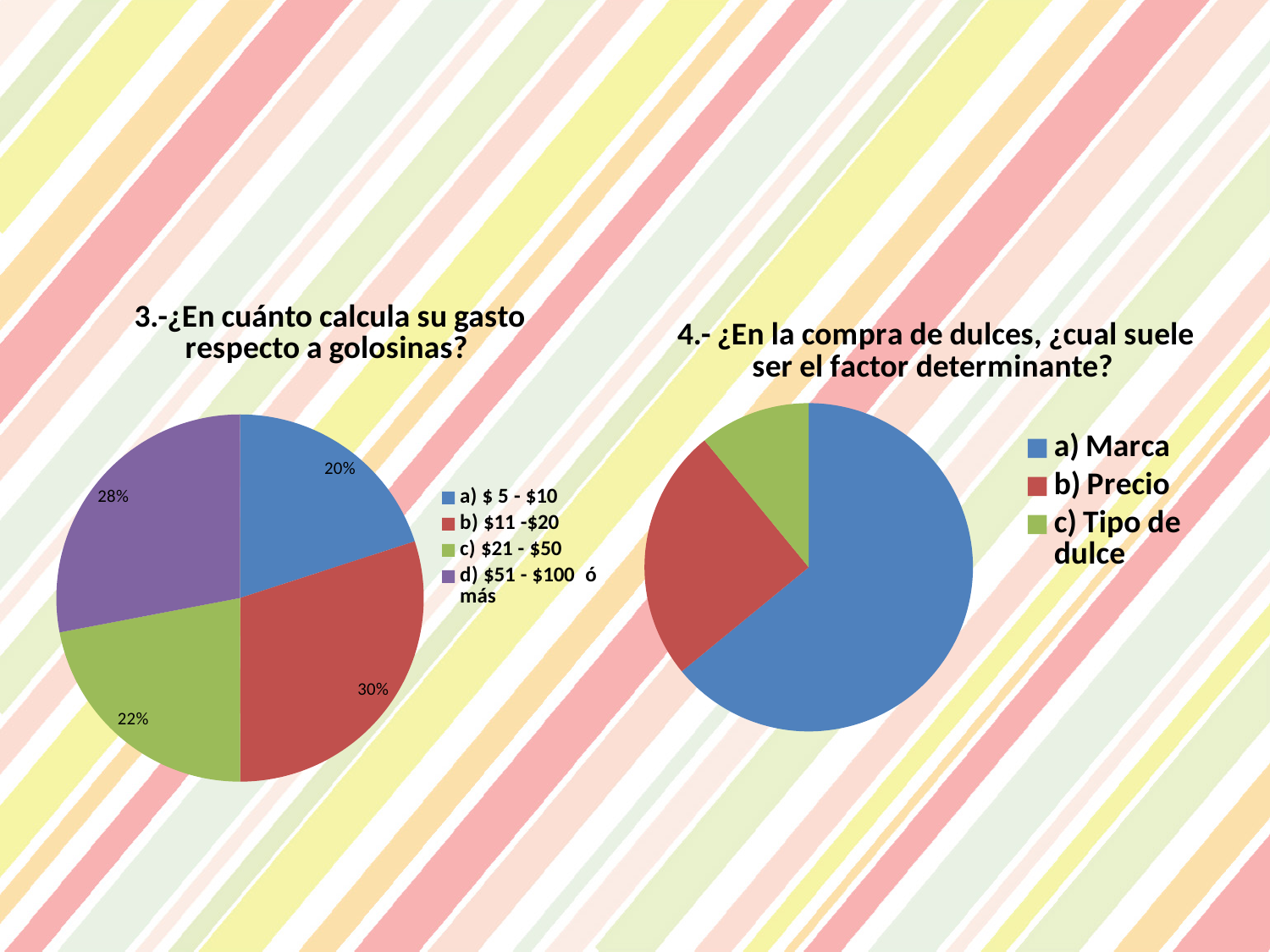
In the chart titled "3.-¿En cuánto calcula su gasto respecto a golosinas?", what is the difference in percentage points between "b) $11 -$20" and "c) $21 - $50"? 8 In the chart titled "4.- ¿En la compra de dulces, ¿cual suele ser el factor determinante?", which category has the smallest share? c) Tipo de dulce In the chart titled "3.-¿En cuánto calcula su gasto respecto a golosinas?", which is larger: "d) $51 - $100 ó más" or "c) $21 - $50"? d) $51 - $100 ó más In the chart titled "3.-¿En cuánto calcula su gasto respecto a golosinas?", what percentage is shown for "d) $51 - $100 ó más"? 28% In the chart titled "3.-¿En cuánto calcula su gasto respecto a golosinas?", what percentage is shown for "a) $ 5 - $10"? 20% How many categories does the legend of the chart titled "3.-¿En cuánto calcula su gasto respecto a golosinas?" list? 4 In the chart titled "3.-¿En cuánto calcula su gasto respecto a golosinas?", which category has the largest share? b) $11 -$20 What type of chart is the one titled "4.- ¿En la compra de dulces, ¿cual suele ser el factor determinante?"? Pie chart In the chart titled "4.- ¿En la compra de dulces, ¿cual suele ser el factor determinante?", what colour is the slice for "b) Precio"? Red In the chart titled "3.-¿En cuánto calcula su gasto respecto a golosinas?", what percentage is shown for "b) $11 -$20"? 30% In the chart titled "4.- ¿En la compra de dulces, ¿cual suele ser el factor determinante?", which category has the largest share? a) Marca In the chart titled "3.-¿En cuánto calcula su gasto respecto a golosinas?", which category has the smallest share? a) $ 5 - $10